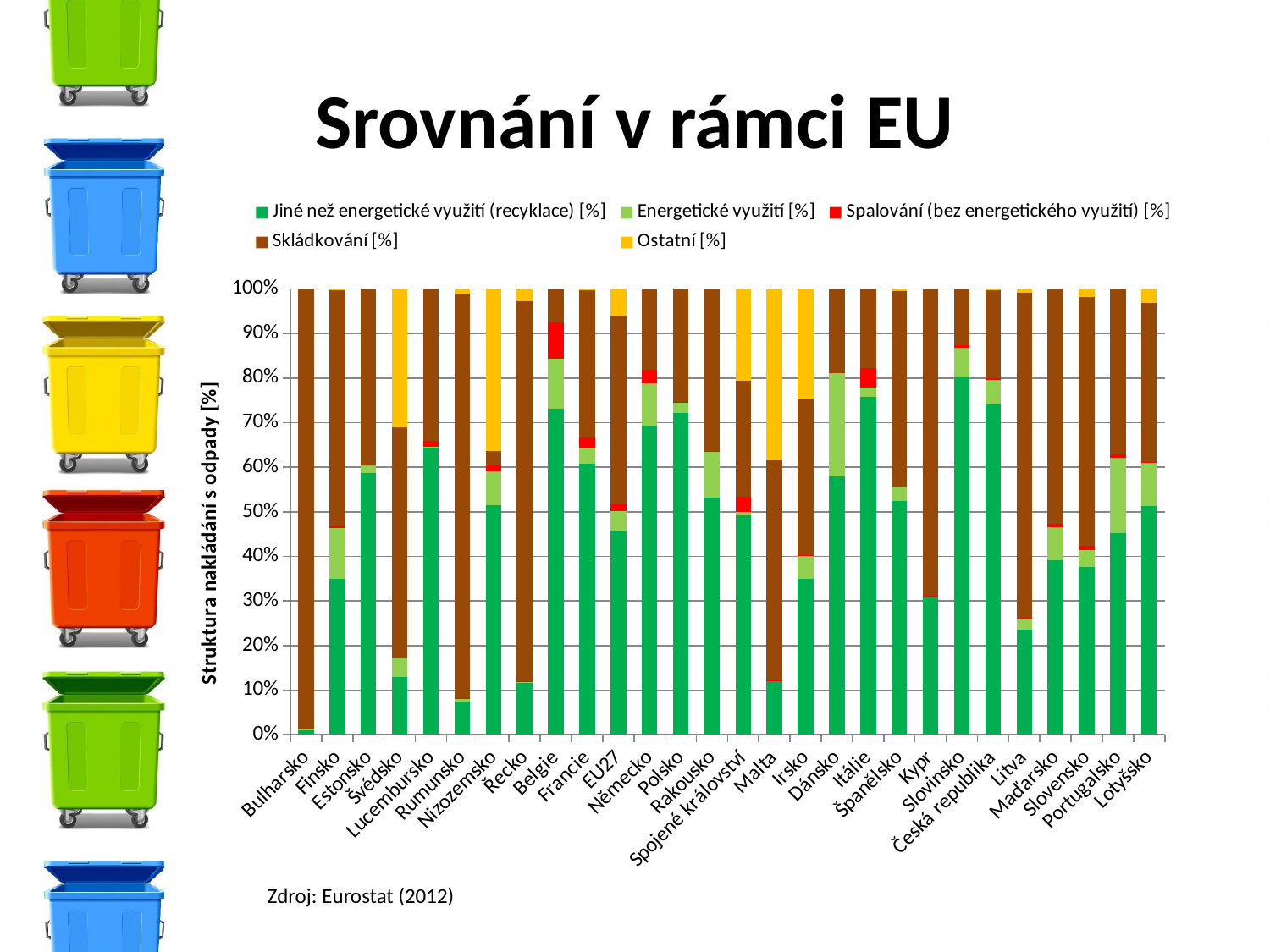
Is the value for 'Jiné než energetické využití (recyklace) [%]' for Lucembursko greater or less than 60%? greater What is the title of the chart's vertical axis? Struktura nakládání s odpady [%] What source is cited below the chart? Zdroj: Eurostat (2012) Which country has the highest value for 'Jiné než energetické využití (recyklace) [%]'? Slovinsko Is the value for 'Jiné než energetické využití (recyklace) [%]' for Bulharsko greater or less than 10%? less How many countries/categories are shown on the x axis? 28 How many series does the legend list? 5 What kind of chart is shown on the slide? Stacked bar chart Is the value for 'Jiné než energetické využití (recyklace) [%]' for Litva greater or less than 30%? less Which has a larger value for 'Jiné než energetické využití (recyklace) [%]', Belgie or Litva? Belgie Which country has the lowest value for 'Jiné než energetické využití (recyklace) [%]'? Bulharsko